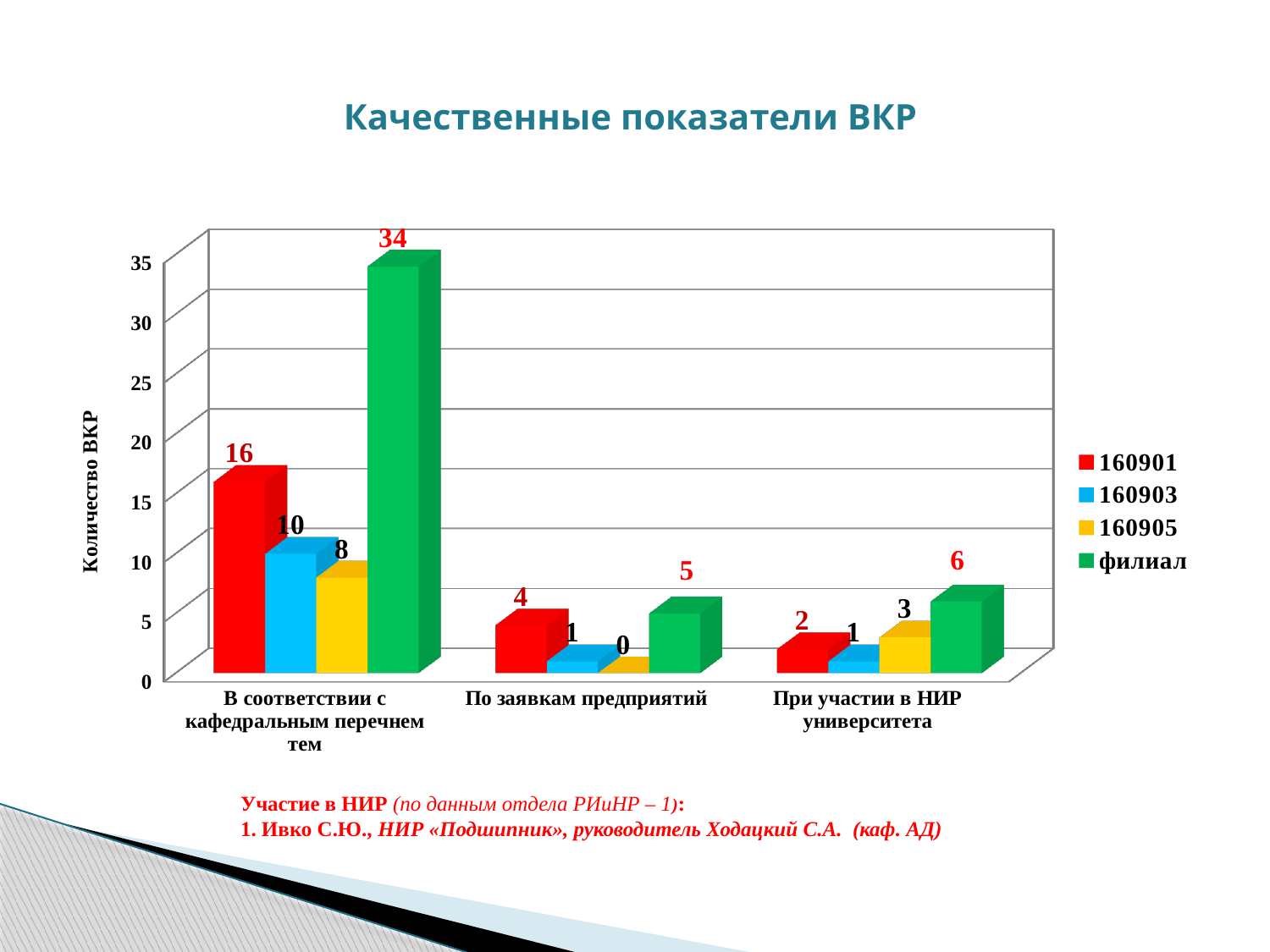
Which series has the highest value in the category «В соответствии с кафедральным перечнем тем»? филиал What is the difference between the values for филиал and 160901 in the category «В соответствии с кафедральным перечнем тем»? 18 What is the value for филиал in the category «В соответствии с кафедральным перечнем тем»? 34 How many series does the legend list? 4 What is the value for 160905 in the category «При участии в НИР университета»? 3 What is the value for 160903 in the category «По заявкам предприятий»? 1 Is the value for 160901 in the category «В соответствии с кафедральным перечнем тем» greater or less than 15? greater How many categories are shown on the x axis? 3 Which is larger: the value for 160901 or for 160905 in the category «При участии в НИР университета»? 160905 Which series has the lowest value in the category «По заявкам предприятий»? 160905 What is the title of the chart? Качественные показатели ВКР What type of chart is shown on the slide? Bar chart